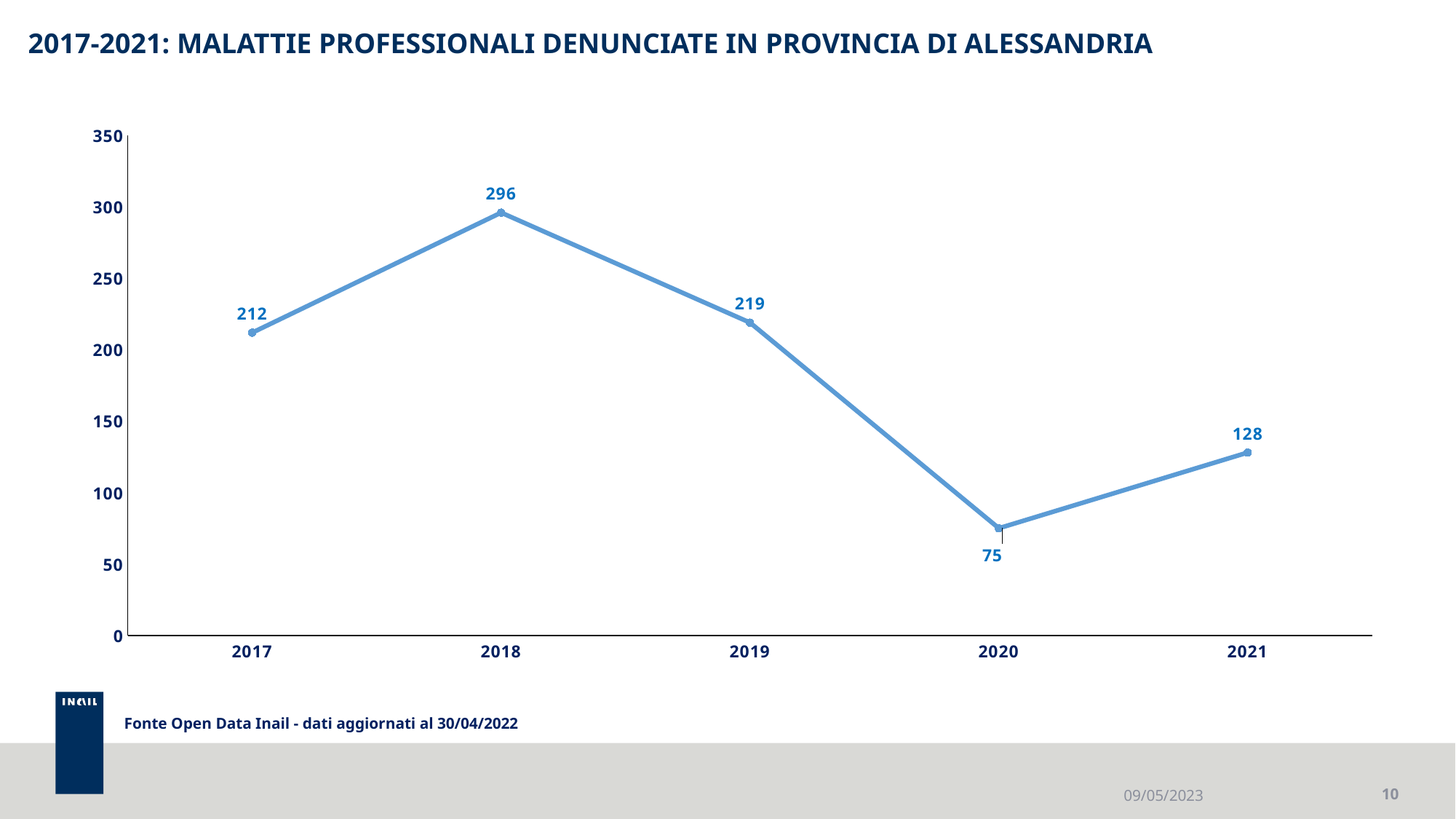
What is the difference between the values for 2021 and 2020? 53 What kind of chart is shown on the slide? line chart What is the value for 2018? 296 What is the difference between the values for 2018 and 2019? 77 How many years are plotted on the chart? 5 Which is larger, the value for 2017 or the value for 2019? 2019 Does the value rise or fall from 2019 to 2020? fall What is the value for 2021? 128 What is the value for 2020? 75 Which year has the lowest value? 2020 Which year has the highest value? 2018 Is the value for 2021 greater or less than 150? less